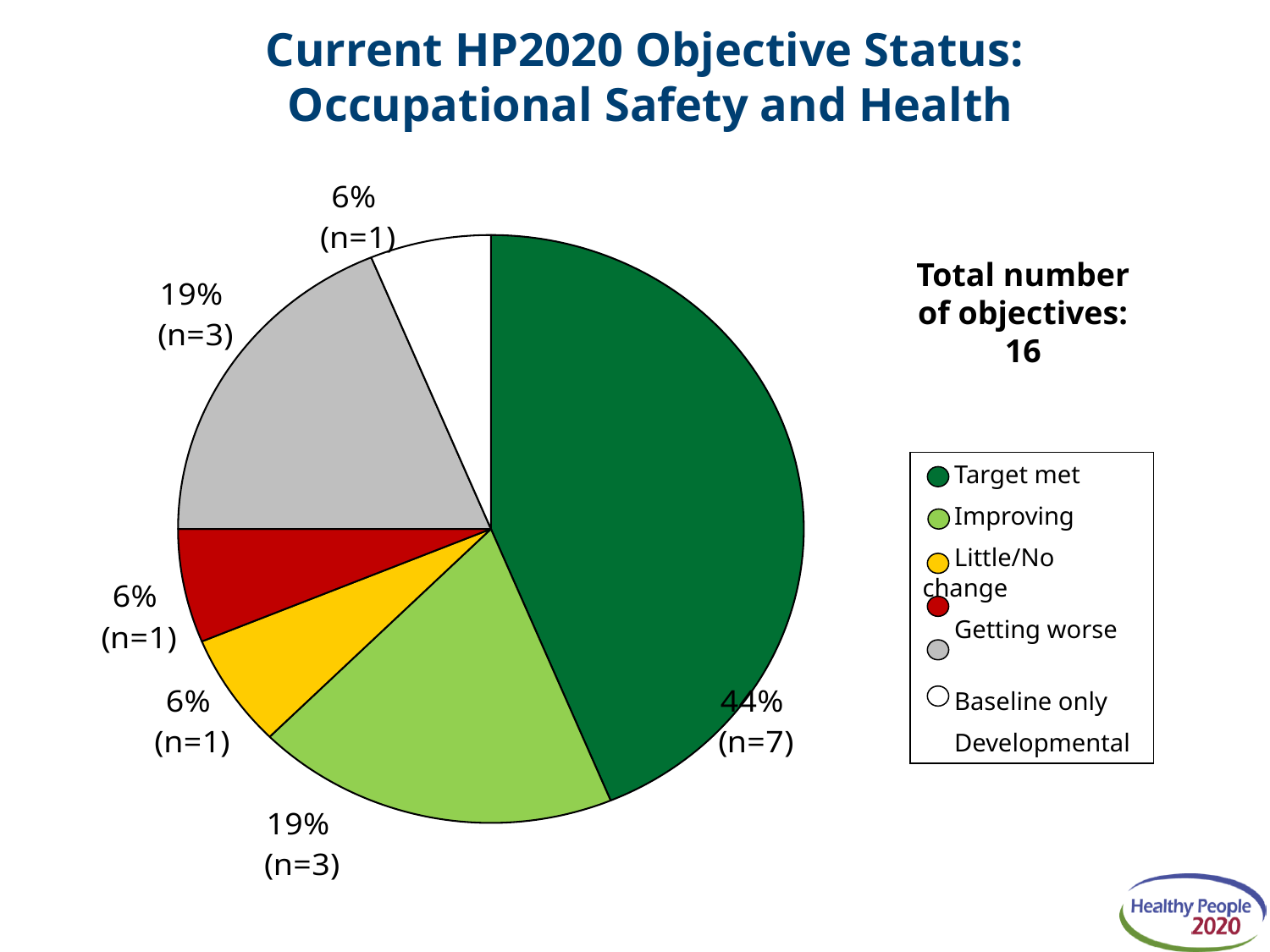
What type of chart is shown on the slide? Pie chart What is the total number of objectives stated on the slide? 16 What percentage of objectives have the status "Improving"? 19% What percentage of objectives have the status "Little/No change"? 6% What colour is the slice representing "Target met"? Dark green How many objectives have the status "Getting worse"? 1 What is the difference in percentage points between the "Target met" share and the "Improving" share? 25 percentage points Which has a larger share of the pie, "Improving" or "Getting worse"? Improving What percentage of objectives have the status "Target met"? 44% How many status categories does the legend list? 6 How many objectives have the status "Target met"? 7 Which status category has the largest share of the pie? Target met